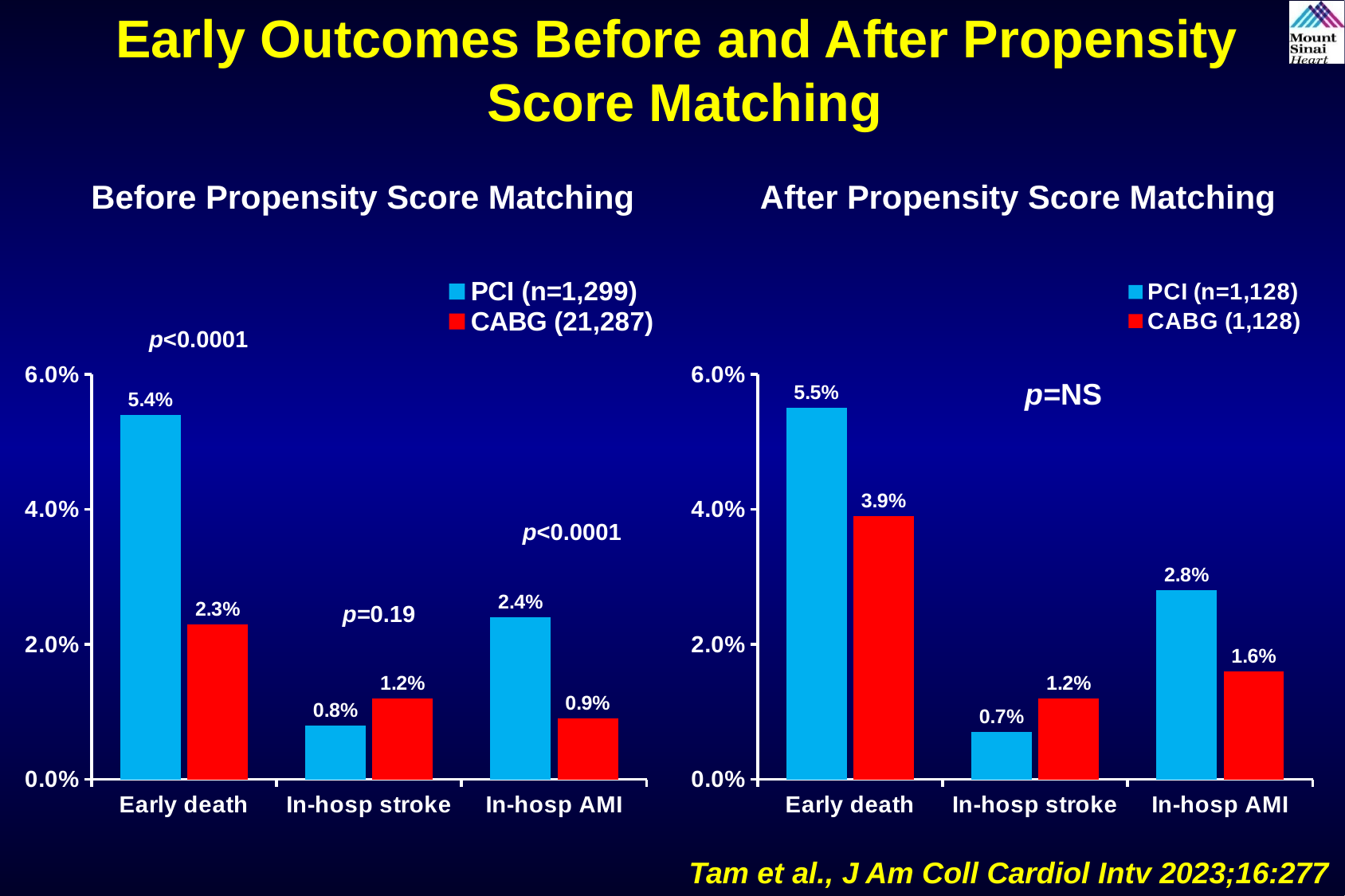
In the 'After Propensity Score Matching' chart, what is the in-hospital stroke rate for PCI? 0.7% In the 'After Propensity Score Matching' chart, what is the early death rate for CABG? 3.9% In the 'Before Propensity Score Matching' chart, what is the difference between the PCI and CABG early death rates? 3.1% What type of chart is the 'After Propensity Score Matching' chart? Bar chart In the 'After Propensity Score Matching' chart, which outcome has the lowest PCI value? In-hosp stroke In the 'Before Propensity Score Matching' chart, what is the early death rate for PCI? 5.4% How many series does the legend of the 'Before Propensity Score Matching' chart list? 2 In the 'Before Propensity Score Matching' chart, which outcome has the highest PCI value? Early death In the 'Before Propensity Score Matching' chart, which is larger for in-hospital stroke, PCI or CABG? CABG In the 'After Propensity Score Matching' chart, what is the difference between the PCI and CABG in-hospital AMI rates? 1.2% How many outcome categories are shown on the x axis of the 'After Propensity Score Matching' chart? 3 In the 'Before Propensity Score Matching' chart, what is the in-hospital AMI rate for CABG? 0.9%